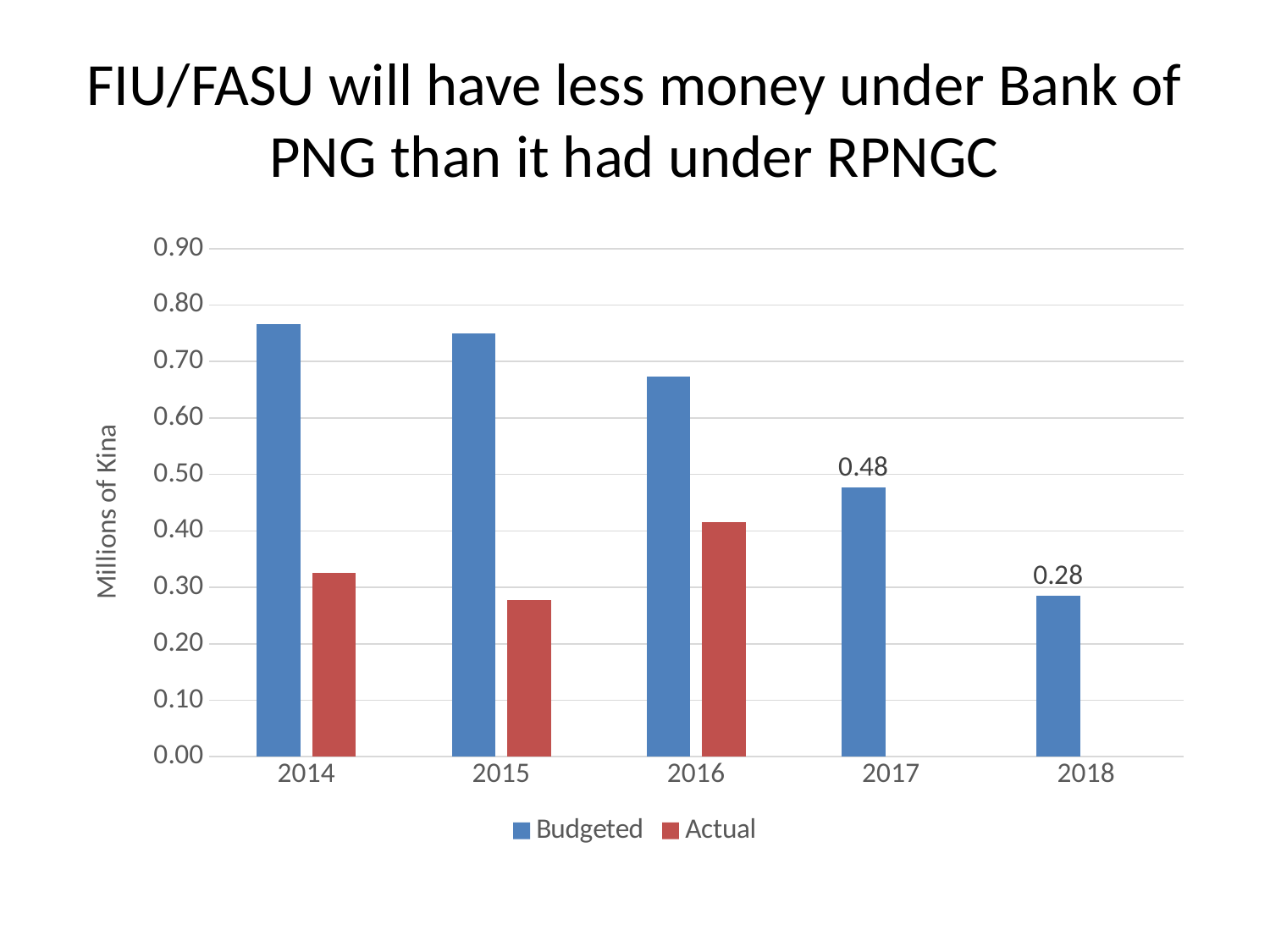
How many years are shown on the x axis? 5 Which year has the highest Actual value? 2016 Which year has the lowest Actual value? 2015 Is the Actual value for 2015 greater or less than 0.30? less Do the Budgeted values rise or fall from 2014 to 2018? fall Which year has the lowest Budgeted value? 2018 How many series does the legend list? 2 What is the difference between the Budgeted values for 2017 and 2018? 0.20 Is the Budgeted value for 2014 greater or less than 0.70? greater What is the Budgeted value for 2018? 0.28 In 2016, which is larger, the Budgeted value or the Actual value? Budgeted What is the Budgeted value for 2017? 0.48